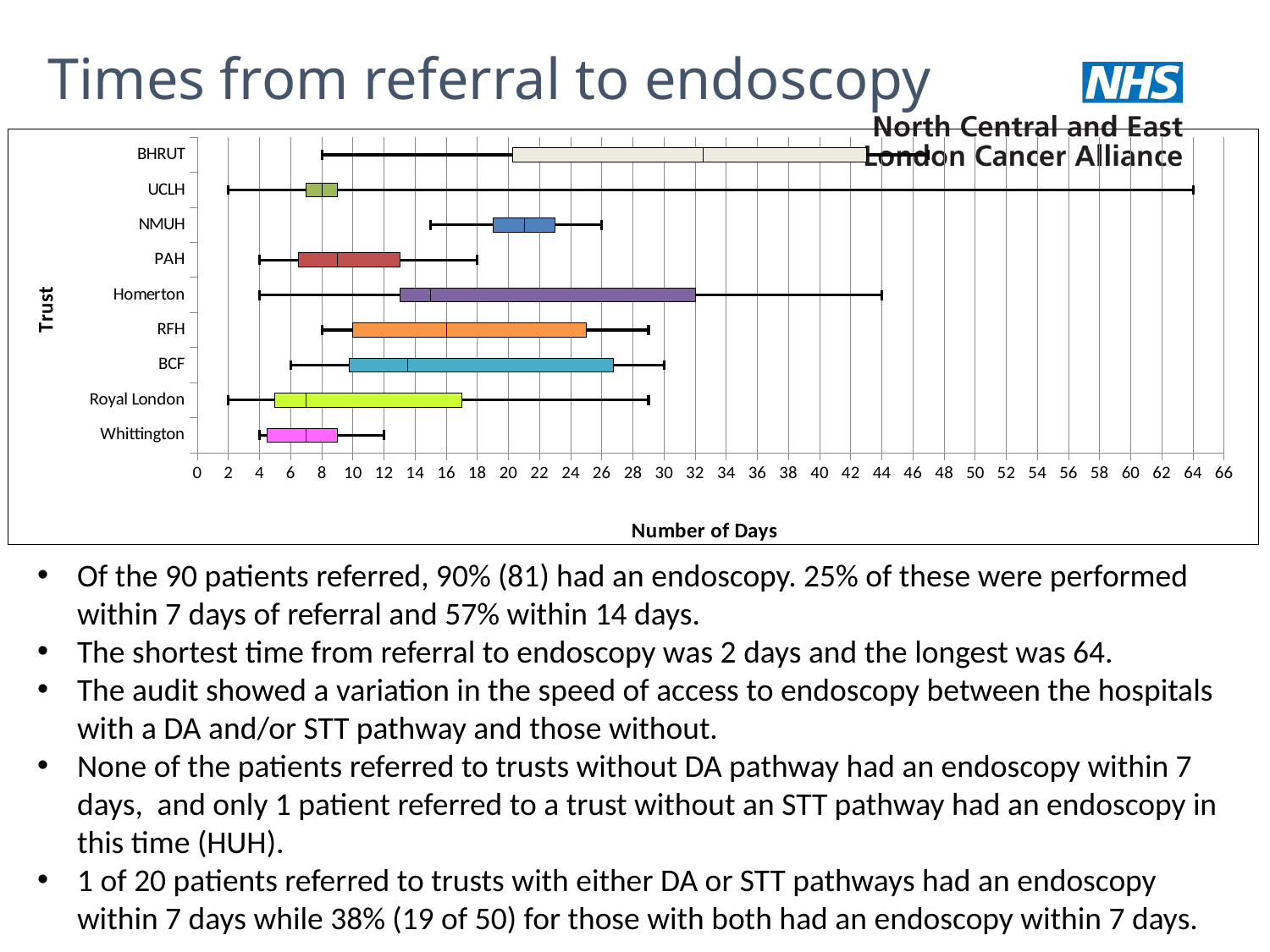
Is the median number of days for NMUH greater or less than 10? greater Which trust is listed at the top of the vertical axis? BHRUT What is the title of the horizontal axis of the chart? Number of Days What is the title of the vertical axis of the chart? Trust Is the upper whisker (maximum) for Whittington greater or less than 20? less Is the upper whisker (maximum) for Homerton greater or less than 40? greater How many trusts are listed on the vertical axis of the chart? 9 Which trust has the highest median number of days from referral to endoscopy? BHRUT Is the median number of days for NMUH larger or smaller than the median for Whittington? larger Is the median number of days for BHRUT larger or smaller than the median for PAH? larger What kind of chart is shown on the slide? Box-and-whisker plot